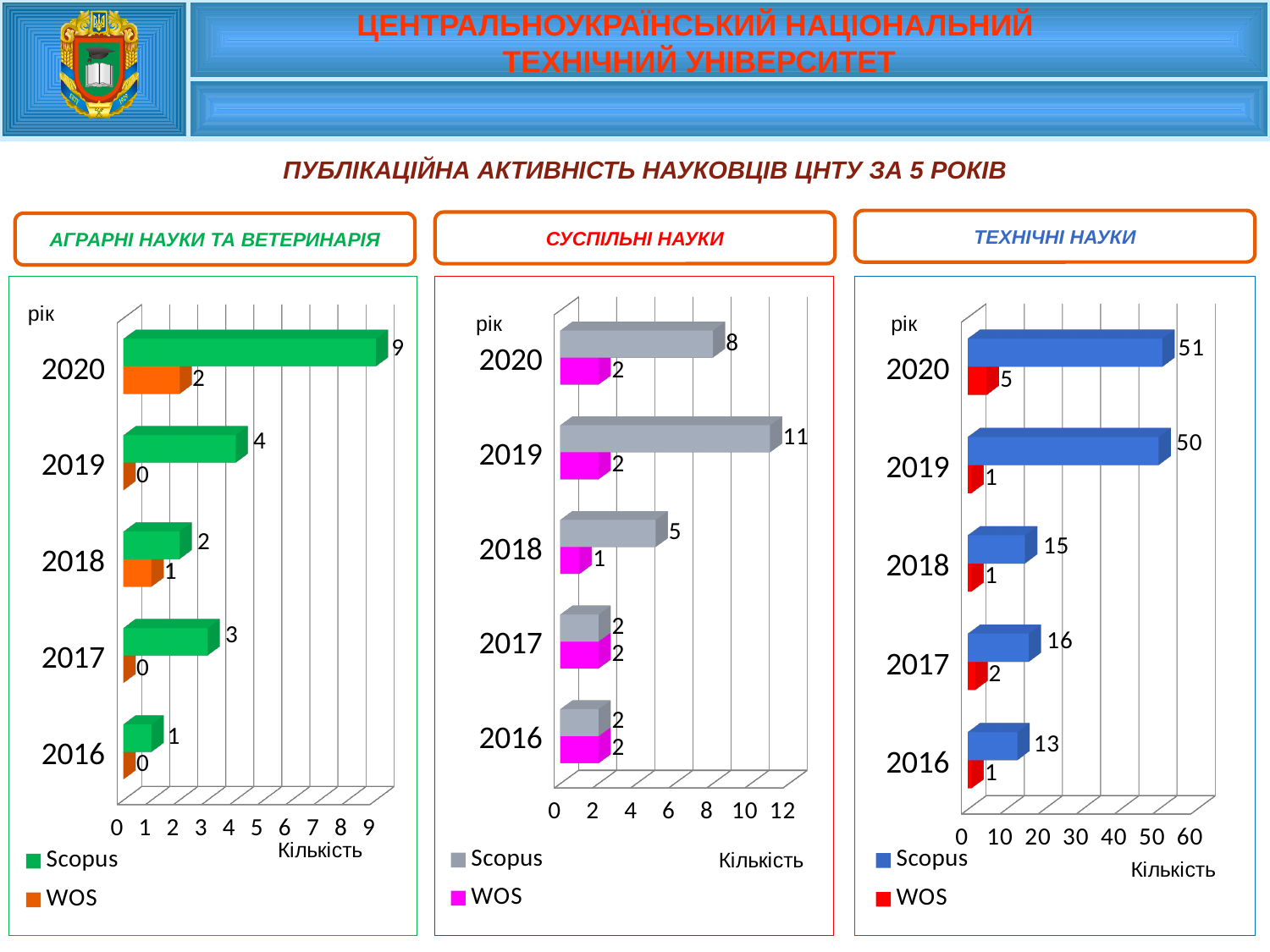
In the 'ТЕХНІЧНІ НАУКИ' chart, which is larger, the Scopus value for 2017 or for 2018? 2017 In the 'СУСПІЛЬНІ НАУКИ' chart, what is the WOS value for 2018? 1 What type of chart is the 'СУСПІЛЬНІ НАУКИ' chart? Bar chart In the 'АГРАРНІ НАУКИ ТА ВЕТЕРИНАРІЯ' chart, which year has the lowest Scopus value? 2016 In the 'СУСПІЛЬНІ НАУКИ' chart, what is the difference between the Scopus values for 2019 and 2020? 3 In the 'АГРАРНІ НАУКИ ТА ВЕТЕРИНАРІЯ' chart, what is the Scopus value for 2020? 9 In the 'АГРАРНІ НАУКИ ТА ВЕТЕРИНАРІЯ' chart, what is the WOS value for 2018? 1 In the 'ТЕХНІЧНІ НАУКИ' chart, what is the difference between the Scopus values for 2020 and 2016? 38 In the 'ТЕХНІЧНІ НАУКИ' chart, what is the WOS value for 2020? 5 In the 'СУСПІЛЬНІ НАУКИ' chart, which year has the highest Scopus value? 2019 In the 'ТЕХНІЧНІ НАУКИ' chart, what is the Scopus value for 2019? 50 How many years are shown in the 'ТЕХНІЧНІ НАУКИ' chart? 5